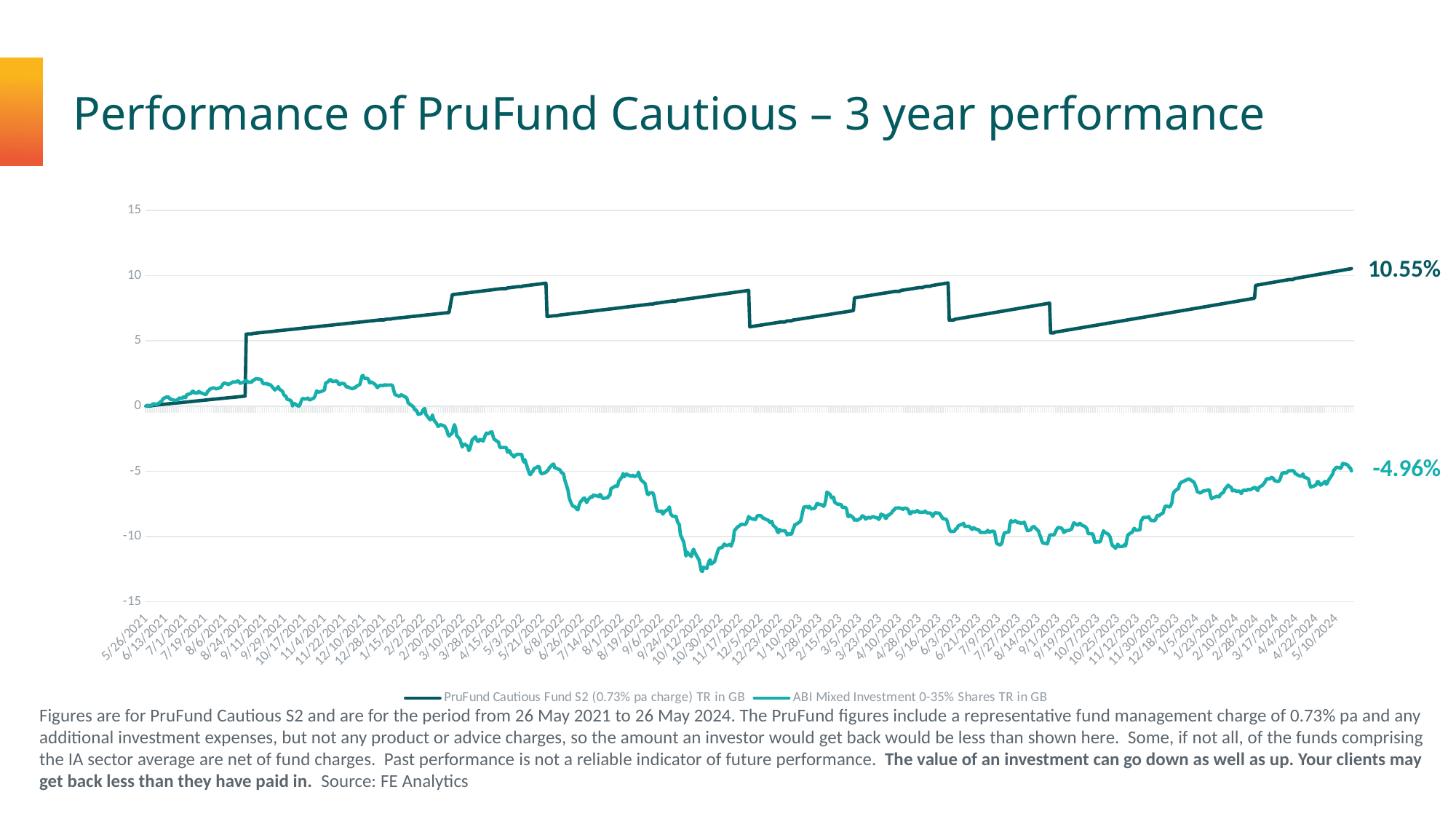
What is the final value shown for the PruFund Cautious Fund S2 (0.73% pa charge) TR in GB series? 10.55% What kind of chart is shown on the slide? Line chart Is the value of the ABI Mixed Investment 0-35% Shares series around 10/30/2022 greater or less than -10? less What is the title of the chart slide? Performance of PruFund Cautious – 3 year performance How many series does the legend list? 2 What is the final value shown for the ABI Mixed Investment 0-35% Shares TR in GB series? -4.96% What is the difference between the final values of the PruFund Cautious Fund S2 series and the ABI Mixed Investment 0-35% Shares series? 15.51 percentage points Which series ends at a higher value, PruFund Cautious Fund S2 or ABI Mixed Investment 0-35% Shares? PruFund Cautious Fund S2 What source is cited for the chart data? FE Analytics Which series has the lower final value? ABI Mixed Investment 0-35% Shares TR in GB Does the PruFund Cautious Fund S2 series rise or fall overall from 5/26/2021 to 5/10/2024? Rise Is the value of the PruFund Cautious Fund S2 series at 1/15/2022 greater or less than 5? greater